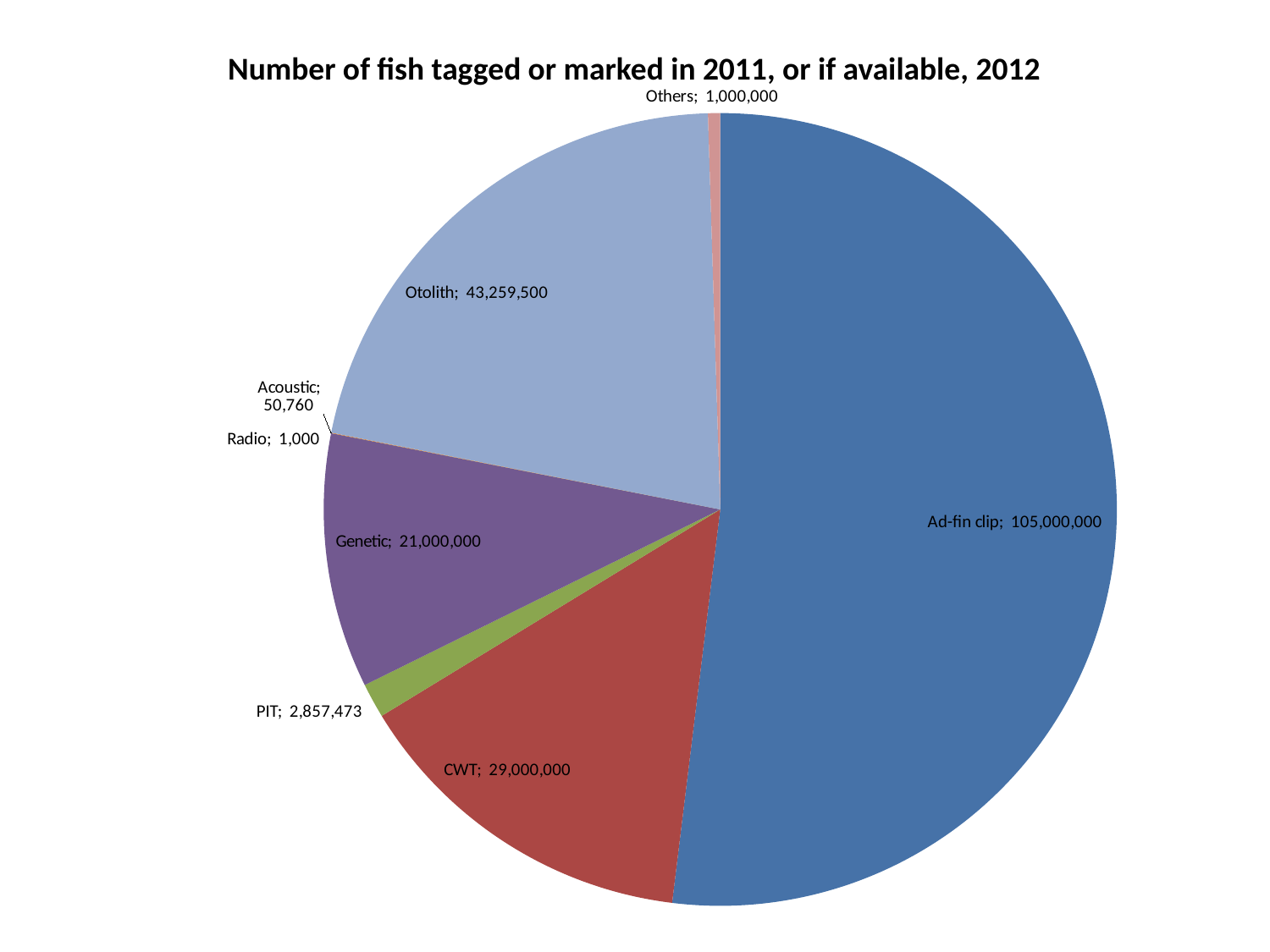
What is the value shown for PIT? 2,857,473 What is the title of the chart? Number of fish tagged or marked in 2011, or if available, 2012 Which is larger, the value for CWT or the value for Genetic? CWT How many categories are shown in the pie chart? 8 What is the value shown for Otolith? 43,259,500 How many fish were tagged or marked with Ad-fin clip? 105,000,000 Which category has the largest slice of the pie? Ad-fin clip What is the difference between the Ad-fin clip value and the CWT value? 76,000,000 What type of chart is shown on the slide? Pie chart What is the value shown for Acoustic? 50,760 What is the difference between the Otolith value and the Genetic value? 22,259,500 Which category has the smallest value? Radio